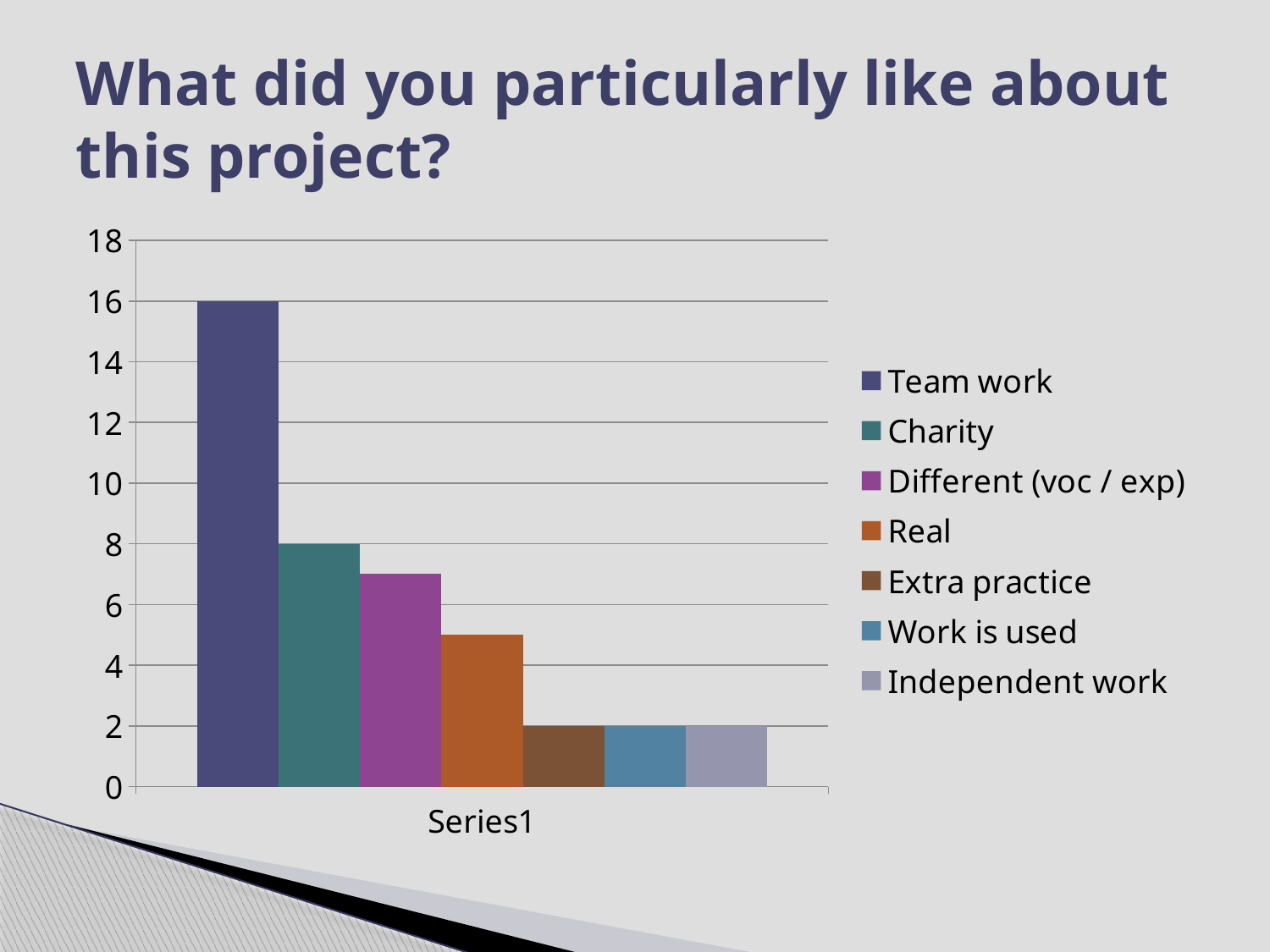
Which legend entry has the highest value? Team work How many entries does the legend list? 7 What type of chart is shown on the slide? bar chart What is the value for Extra practice? 2 Is the value for Real greater or less than 6? less Which is larger, the value for Charity or the value for Real? Charity What is the value for Charity? 8 What is the value for Independent work? 2 Is the value for Different (voc / exp) greater or less than 6? greater What is the value for Team work? 16 How many bars are plotted in the chart? 7 What is the difference between the values for Team work and Charity? 8